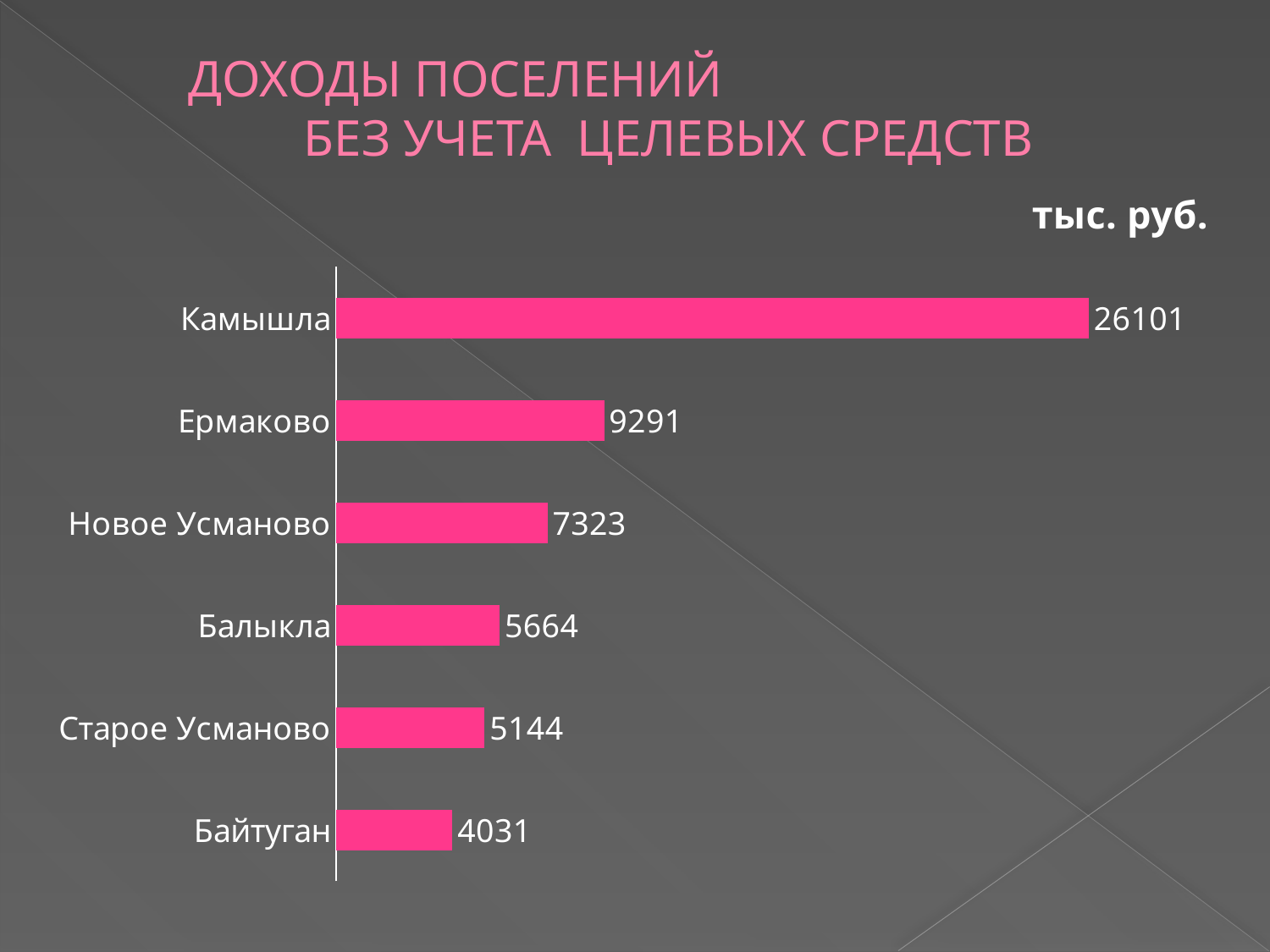
How many settlements are shown in the chart? 6 What is the value for Ермаково? 9291 Which settlement has the lowest value? Байтуган What is the difference between the values for Балыкла and Старое Усманово? 520 What is the difference between the values for Камышла and Ермаково? 16810 What is the value for Камышла? 26101 Which is larger, the value for Новое Усманово or the value for Балыкла? Новое Усманово What is the value for Новое Усманово? 7323 What is the value for Байтуган? 4031 Which settlement has the highest value? Камышла What kind of chart is shown on the slide? Bar chart What unit is indicated for the values in the chart? тыс. руб.